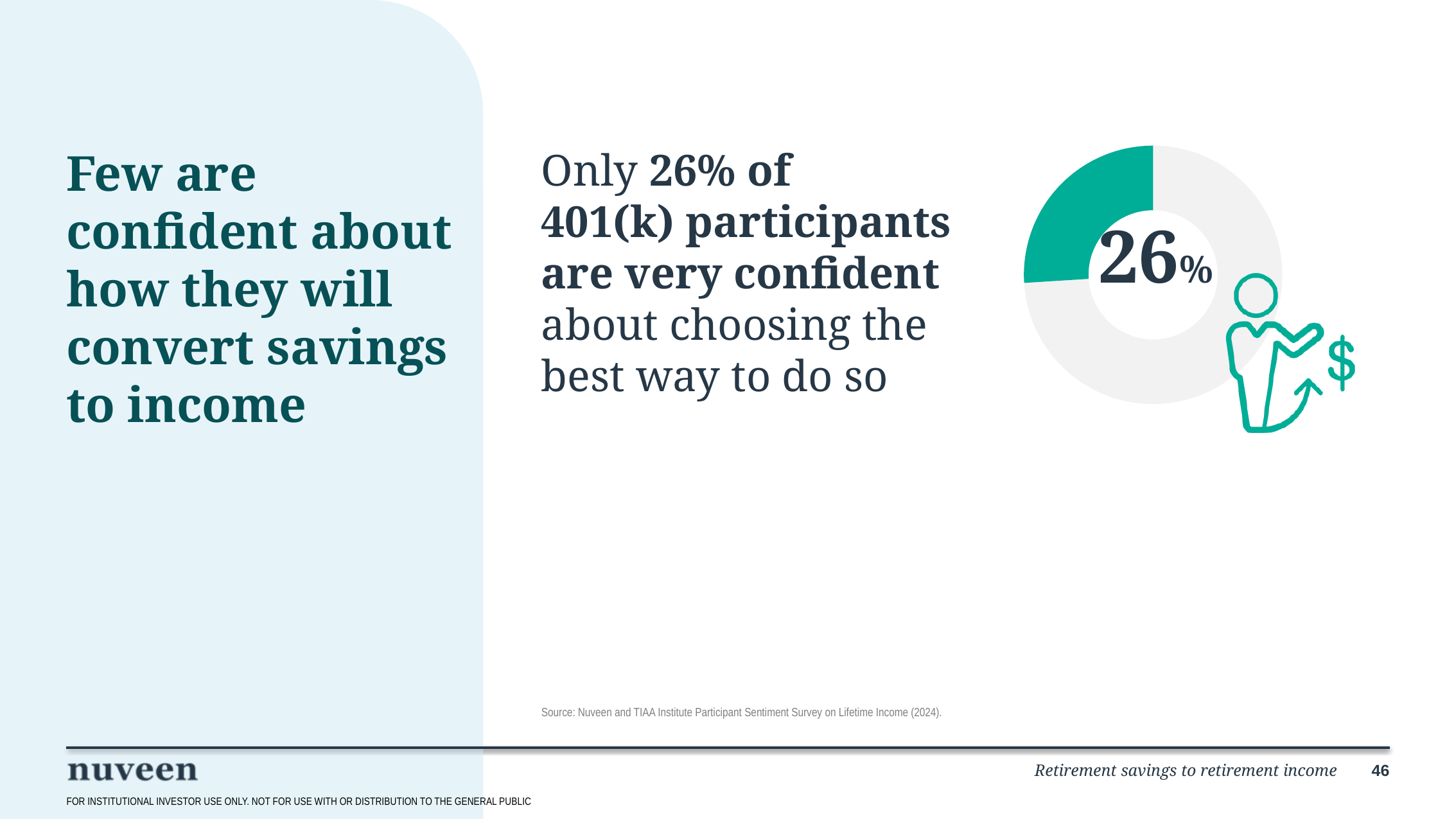
Is the green segment of the donut chart greater or less than 50%? less What is the difference between the grey segment and the green segment of the donut chart? 48% Which segment of the donut chart is larger, the green one or the grey one? The grey one How many segments does the donut chart have? 2 What percentage is shown in the centre of the donut chart? 26% What share of the donut chart does the grey segment represent? 74% What does the 26% in the donut chart represent, according to the slide text? 401(k) participants who are very confident about choosing the best way to convert savings to income What share of the donut chart does the green segment represent? 26% What kind of chart is shown on the slide? Donut (pie) chart What colour is the highlighted 26% segment of the donut chart? Green